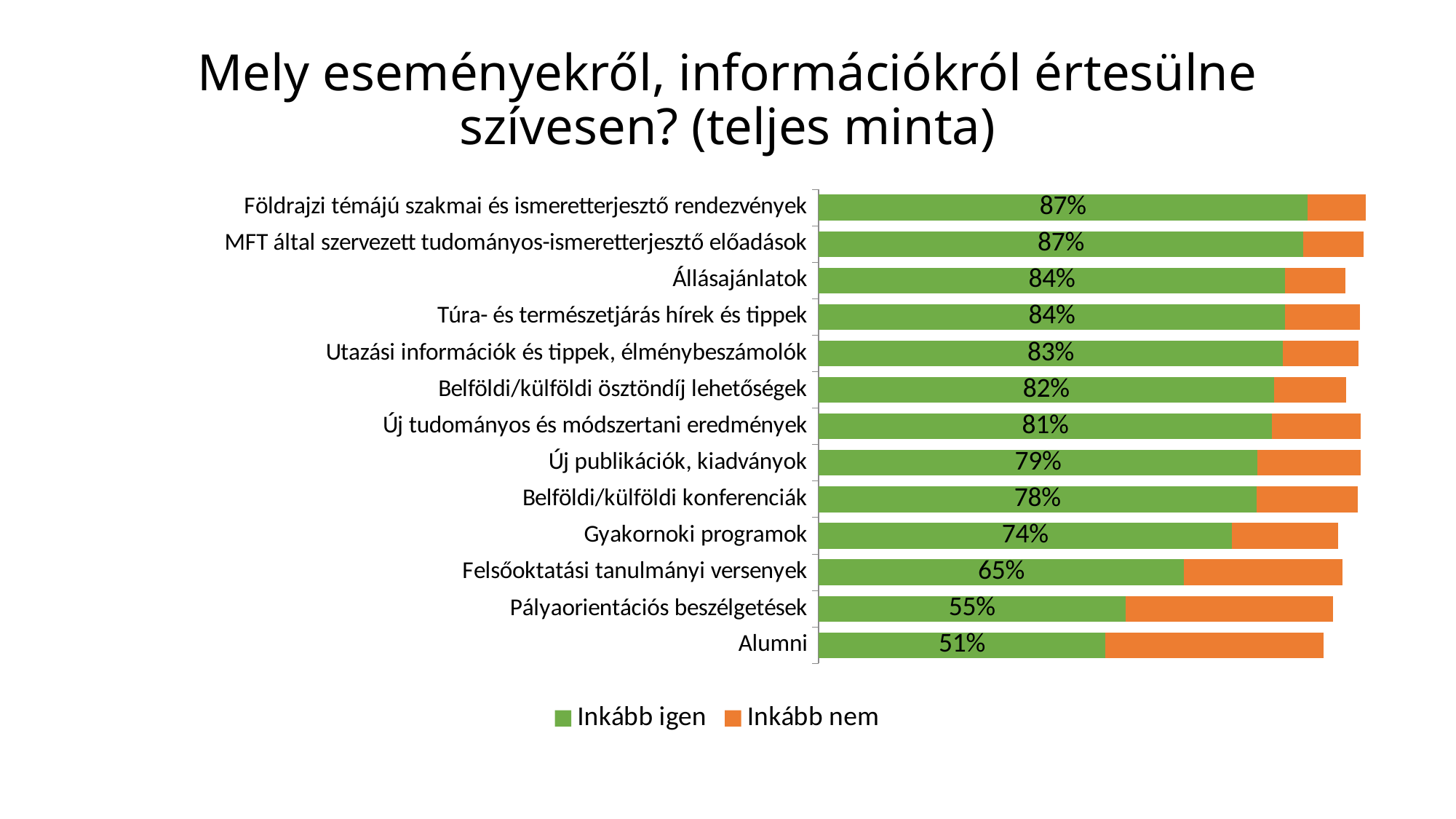
What is the difference between the 'Inkább igen' values for Felsőoktatási tanulmányi versenyek and Alumni? 14% What is the 'Inkább igen' value for Pályaorientációs beszélgetések? 55% What is the 'Inkább igen' value for Alumni? 51% What kind of chart is shown on the slide? Stacked bar chart What is the difference between the 'Inkább igen' values for Földrajzi témájú szakmai és ismeretterjesztő rendezvények and Gyakornoki programok? 13% What is the 'Inkább igen' value for Állásajánlatok? 84% How many series does the legend list? 2 What is the 'Inkább igen' value for Gyakornoki programok? 74% Which colour represents the 'Inkább nem' series? Orange Which has a higher 'Inkább igen' value: Új publikációk, kiadványok or Belföldi/külföldi konferenciák? Új publikációk, kiadványok Which category has the lowest 'Inkább igen' value? Alumni How many categories are shown in the chart? 13